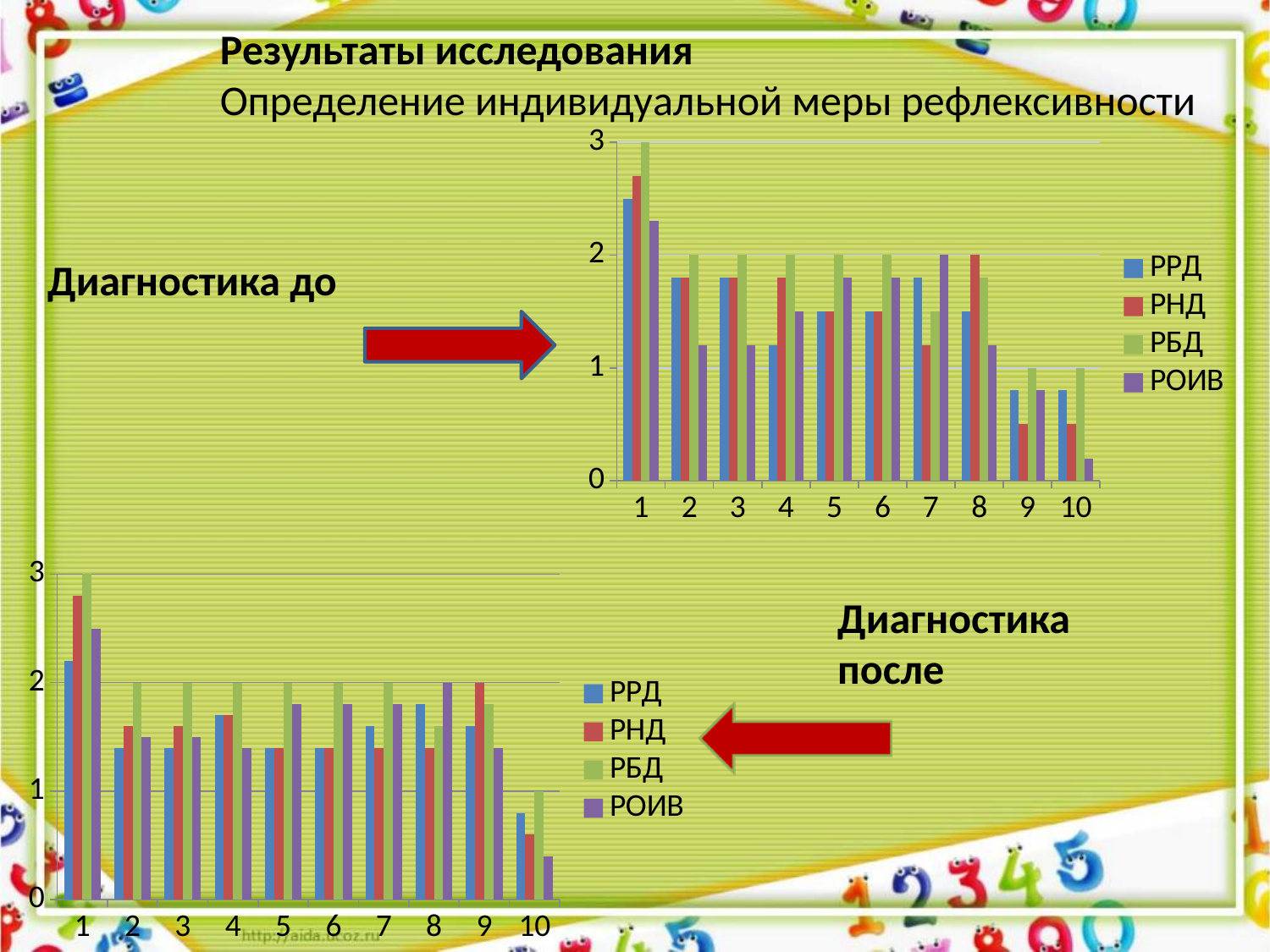
In the bottom-left chart (Диагностика после), what is the value of РБД for category 10? 1 How many categories are shown on the x axis of the top-right chart (Диагностика до)? 10 In the bottom-left chart (Диагностика после), what is the value of РОИВ for category 8? 2 In the top-right chart (Диагностика до), what is the value of РНД for category 8? 2 What kind of chart is the top-right chart (Диагностика до)? bar chart How many series does the legend of the bottom-left chart (Диагностика после) list? 4 In the bottom-left chart (Диагностика после), is the value of РНД for category 1 greater or less than 2? greater In the bottom-left chart (Диагностика после), which category has the lowest РОИВ value? 10 In the top-right chart (Диагностика до), what is the value of РБД for category 1? 3 In the top-right chart (Диагностика до), which category has the highest РБД value? 1 In the top-right chart (Диагностика до), for category 1, which is larger: РБД or РОИВ? РБД In the top-right chart (Диагностика до), is the value of РОИВ for category 10 greater or less than 1? less